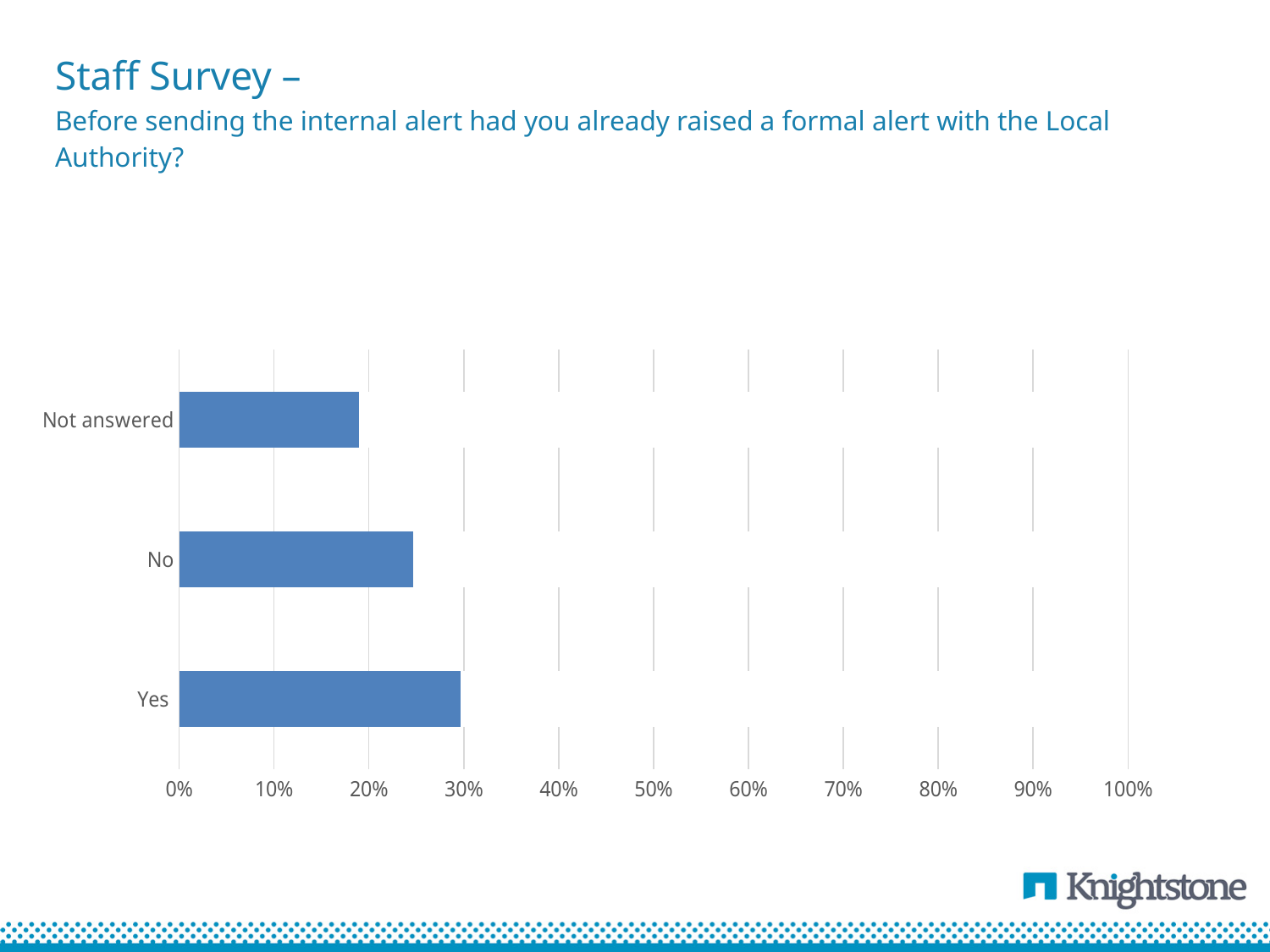
Which is larger, the value for Yes or the value for No? Yes How many categories are shown on the chart? 3 Is the value for No greater or less than 20%? greater Is the value for Not answered greater or less than 10%? greater Which category has the highest value? Yes What is the highest value shown on the horizontal axis of the chart? 100% Is the value for No greater or less than 30%? less Which category has the lowest value? Not answered Which is larger, the value for No or the value for Not answered? No What kind of chart is shown on the slide? bar chart